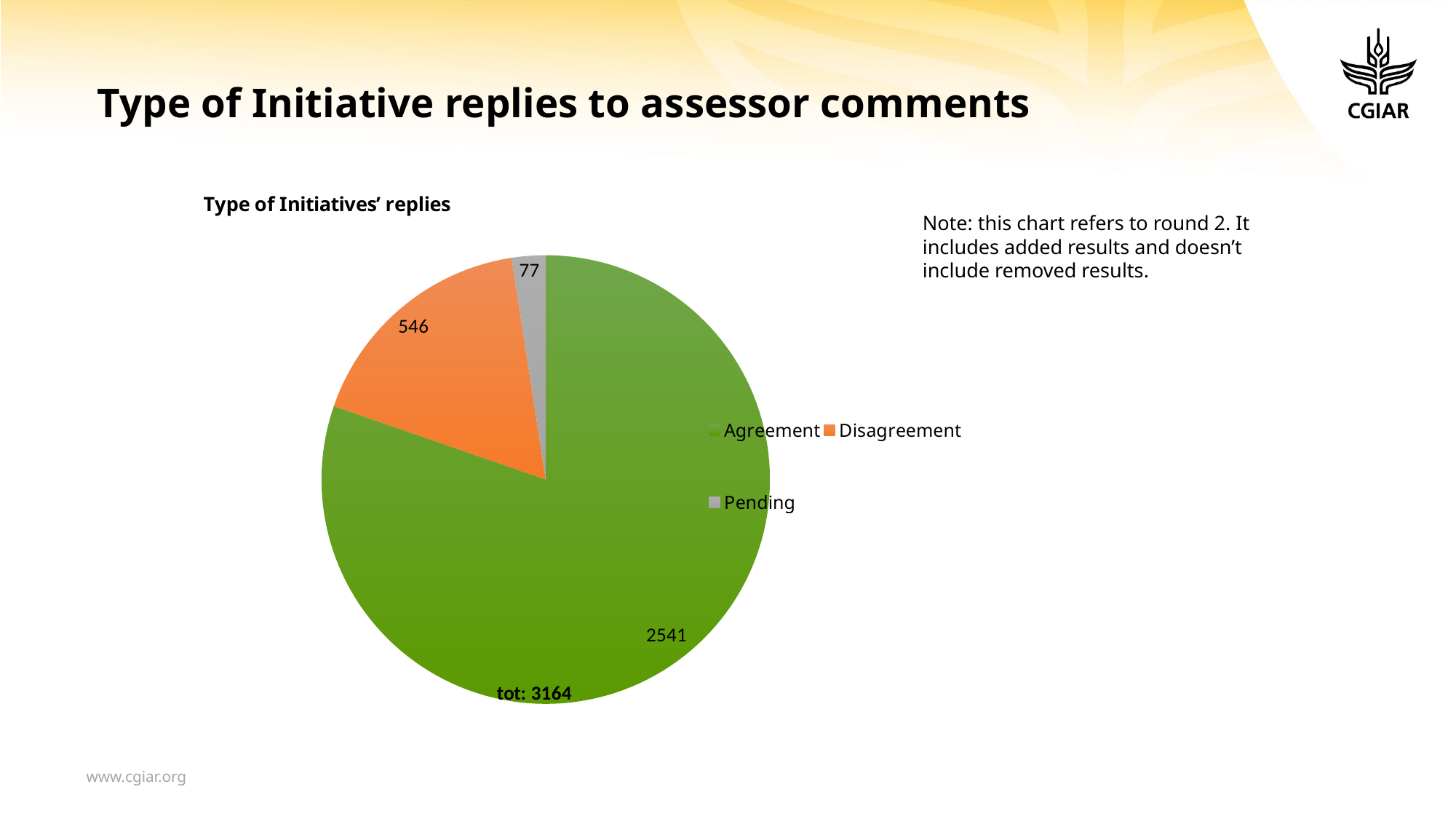
How many slices does the pie chart have? 3 Which is larger, Disagreement or Pending? Disagreement What total is printed on the chart? tot: 3164 What is the value for Pending? 77 Which category has the largest slice? Agreement Which category has the smallest slice? Pending What is the value for Agreement? 2541 What is the difference between the Disagreement and Pending values? 469 What is the value for Disagreement? 546 What kind of chart is shown on the slide? pie chart How many entries does the legend list? 3 What is the title of the chart? Type of Initiatives' replies